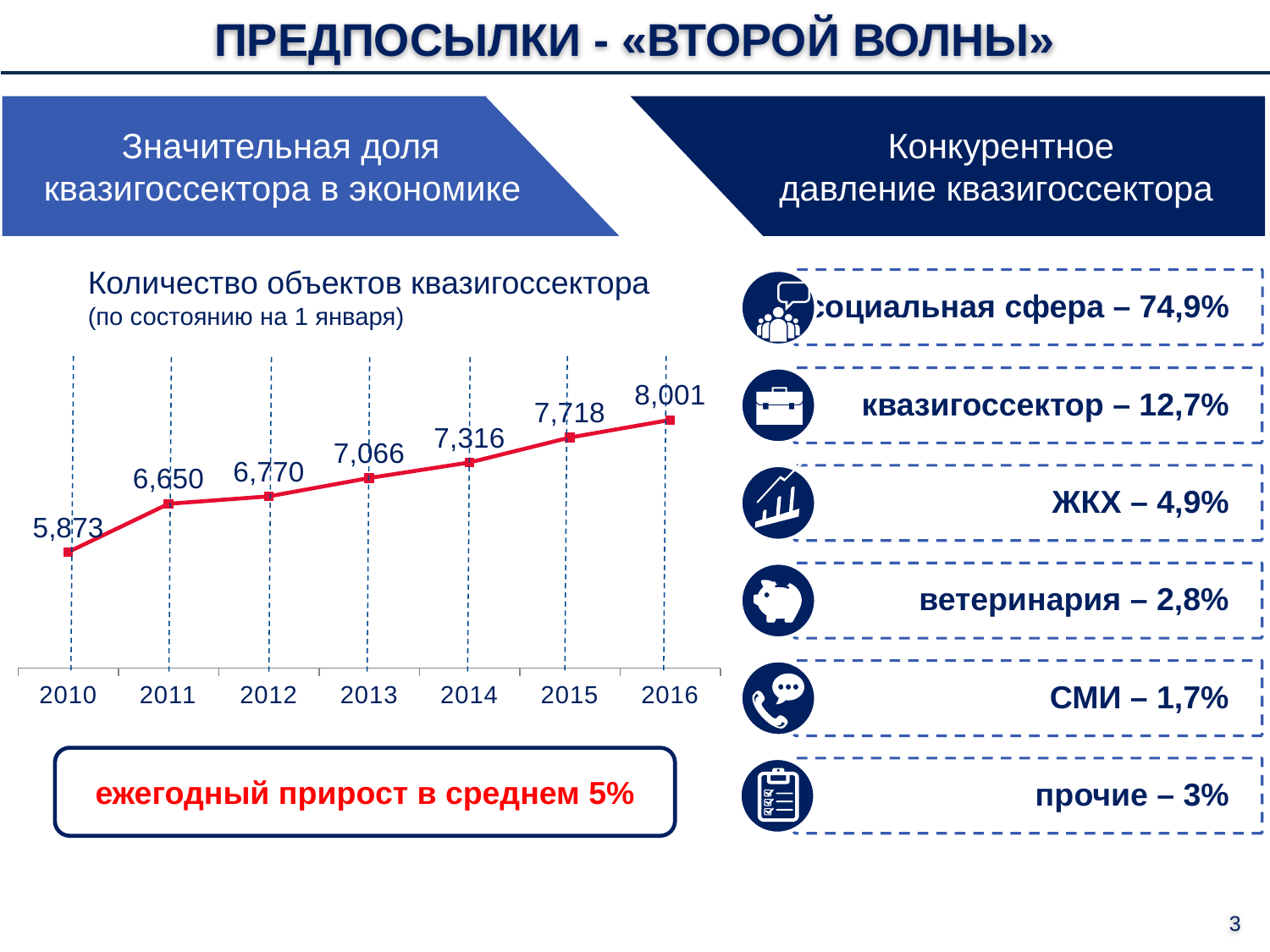
What is the difference between the values for 2016 and 2010? 2,128 What is the value for 2010 in the chart? 5,873 What type of chart is shown on the slide? line chart Do the values rise or fall from 2010 to 2016? rise Which year has the highest value in the chart? 2016 What is the value for 2011 in the chart? 6,650 How many years are plotted in the chart? 7 What is the value for 2013 in the chart? 7,066 What is the difference between the values for 2012 and 2011? 120 Which is larger, the value for 2014 or the value for 2015? 2015 Which year has the lowest value in the chart? 2010 What is the value for 2016 in the chart? 8,001